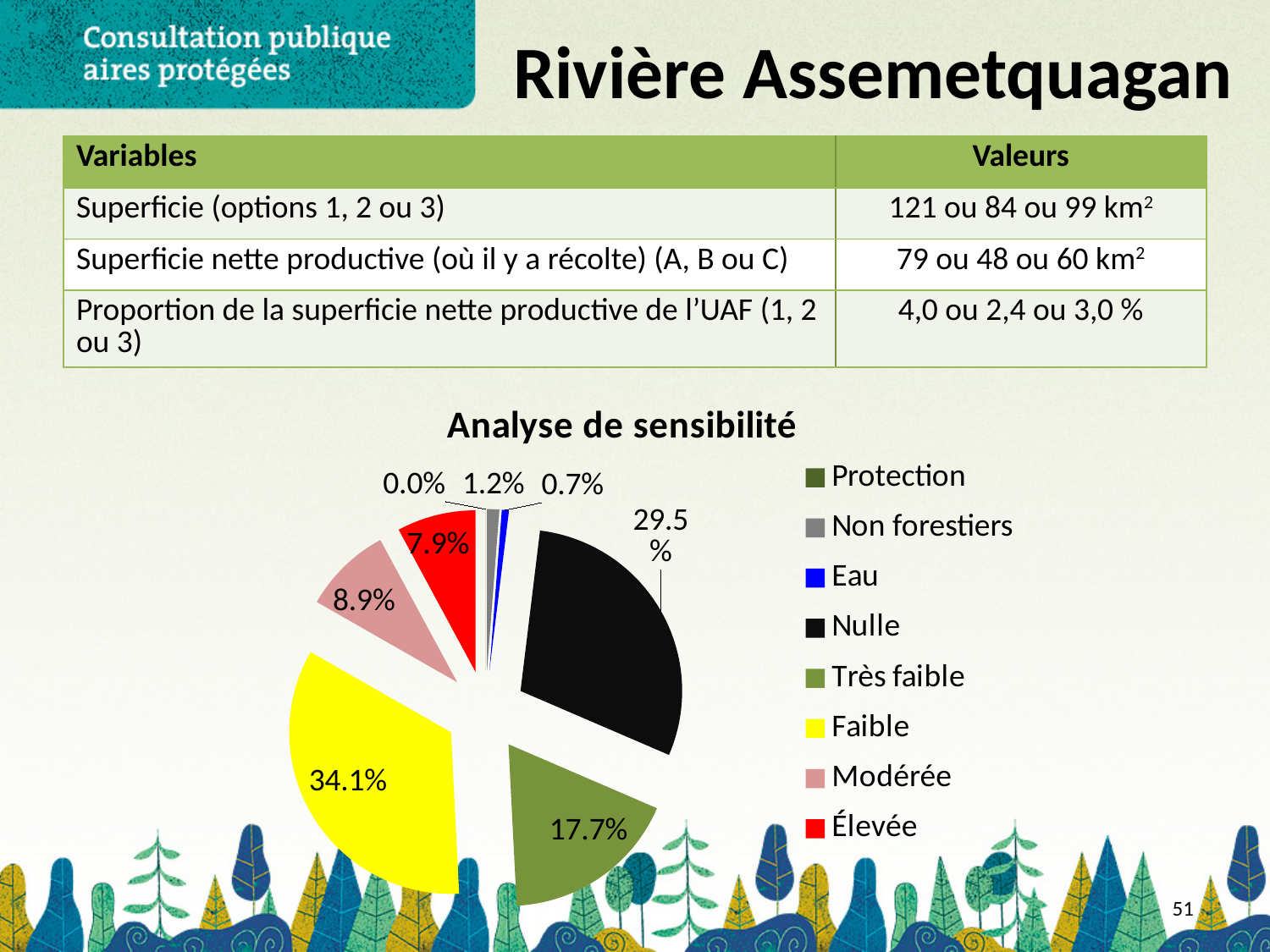
What percentage does the "Nulle" slice represent in the pie chart? 29.5% What percentage does the "Modérée" slice represent in the pie chart? 8.9% Which category has the largest share in the pie chart? Faible What is the title of the chart on the slide? Analyse de sensibilité Which is larger in the pie chart, the "Nulle" slice or the "Très faible" slice? Nulle What percentage does the "Non forestiers" slice represent in the pie chart? 1.2% What type of chart is shown under the title "Analyse de sensibilité"? pie chart What is the difference between the "Faible" and "Nulle" shares in the pie chart? 4.6% What percentage does the "Faible" slice represent in the pie chart? 34.1% What percentage does the "Très faible" slice represent in the pie chart? 17.7% What percentage does the "Élevée" slice represent in the pie chart? 7.9% How many categories does the legend of the pie chart list? 8